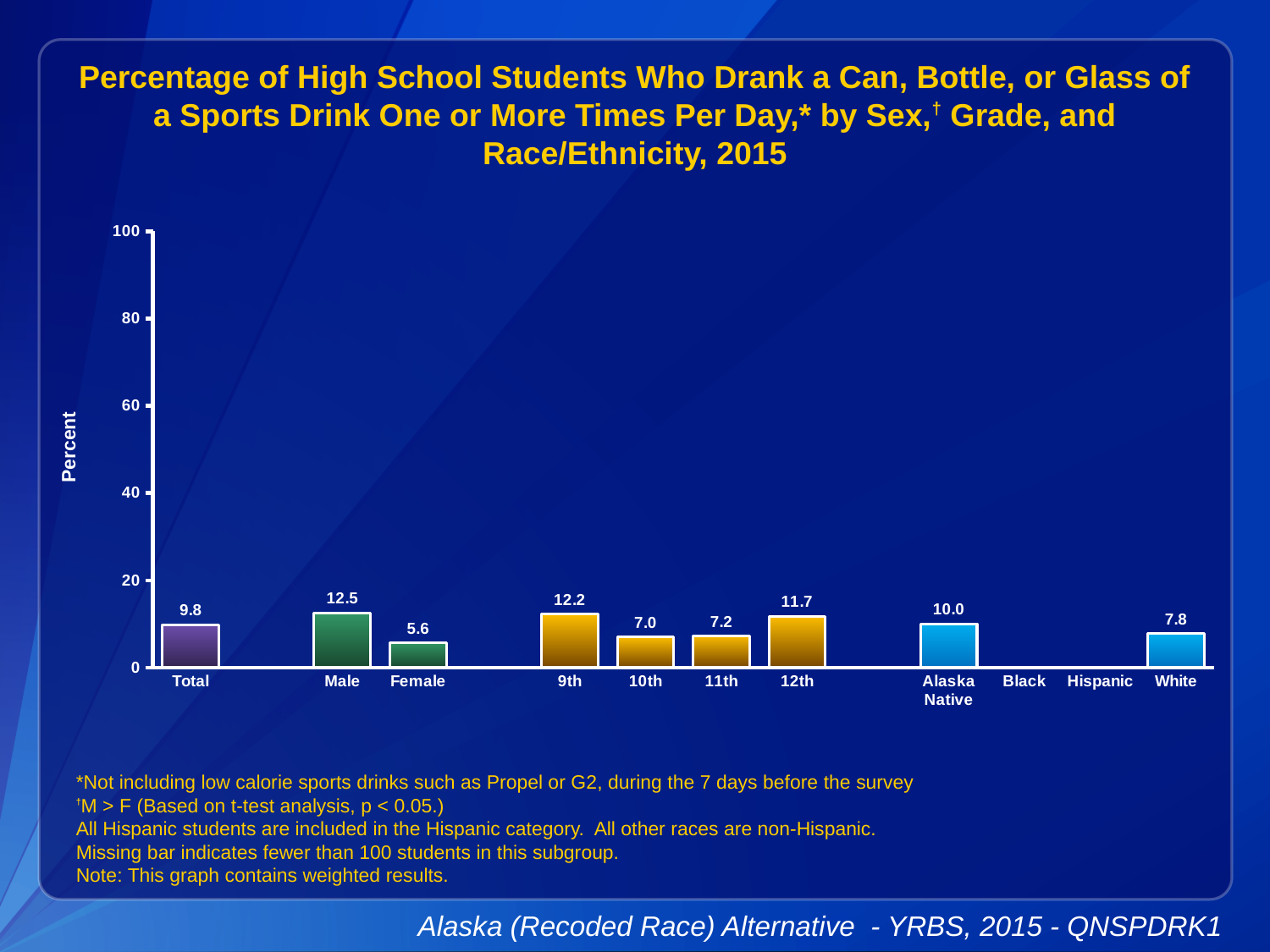
What is the value for 12th grade? 11.7 What kind of chart is shown? bar chart How many categories are labeled on the x axis? 11 What is the value for Male? 12.5 Which category has the lowest value among the bars shown? Female Which category has the highest value? Male Is the value for Total greater or less than 20? less What is the difference between the Male and Female values? 6.9 What is the value for Alaska Native? 10.0 What is the value for Female? 5.6 Which is larger, the value for 9th grade or the value for 10th grade? 9th Which categories have no bar shown? Black and Hispanic